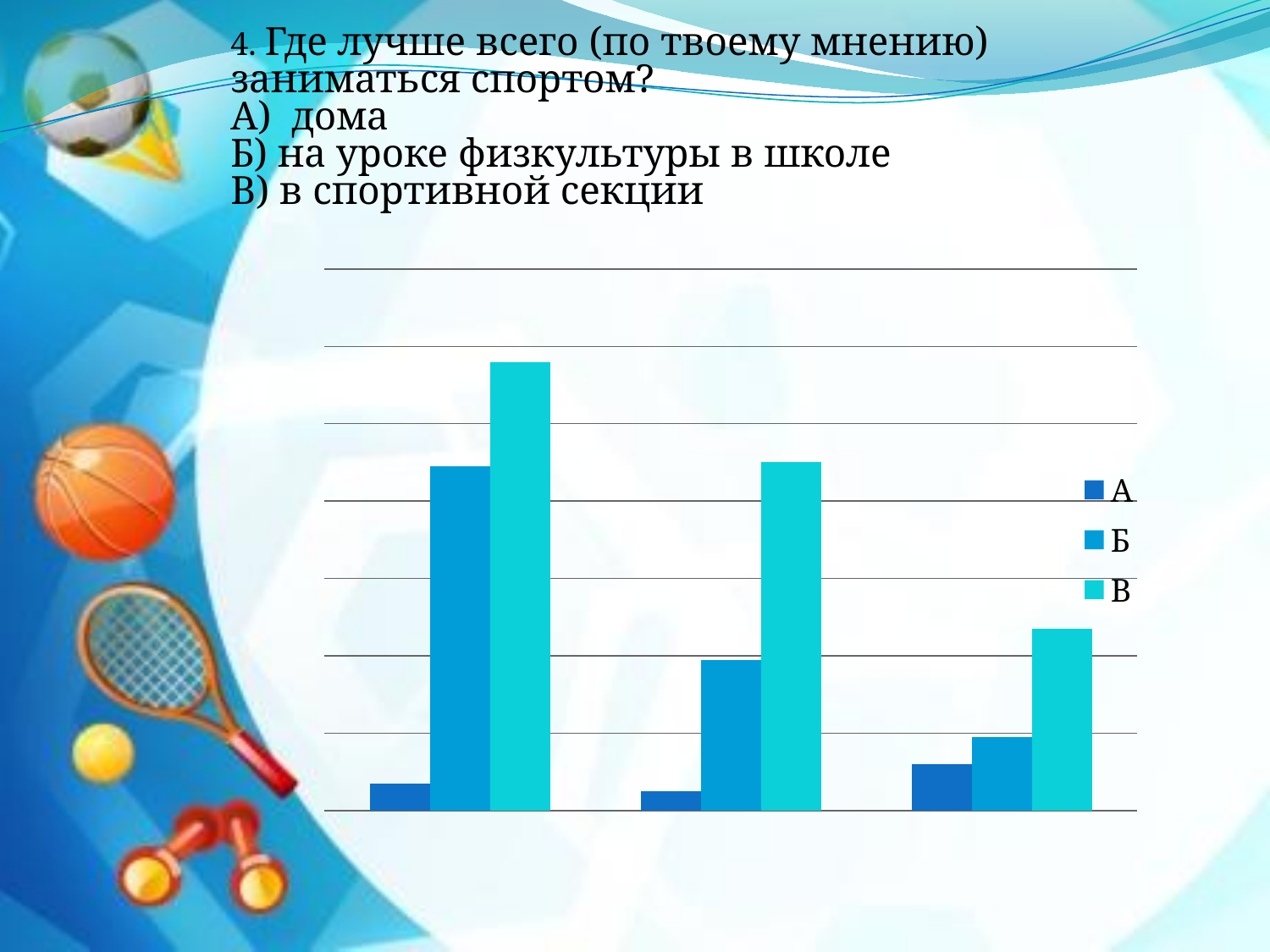
How many groups of bars are plotted in the chart? 3 In the first (leftmost) group of bars, which series has the tallest bar? В Which series is shown in the darkest blue colour in the legend? А In the first (leftmost) group of bars, which series has the shortest bar? А What kind of chart is shown on the slide? bar chart What are the series names listed in the chart legend? А, Б, В Does the bar for series В rise or fall from the first group to the third group? fall Which group of bars contains the tallest bar in the whole chart: the first, second or third? first How many series does the chart legend list? 3 In the middle group of bars, which is larger: the bar for series Б or the bar for series А? Б In the third (rightmost) group of bars, which series has the shortest bar? А In the second (middle) group of bars, which series has the tallest bar? В